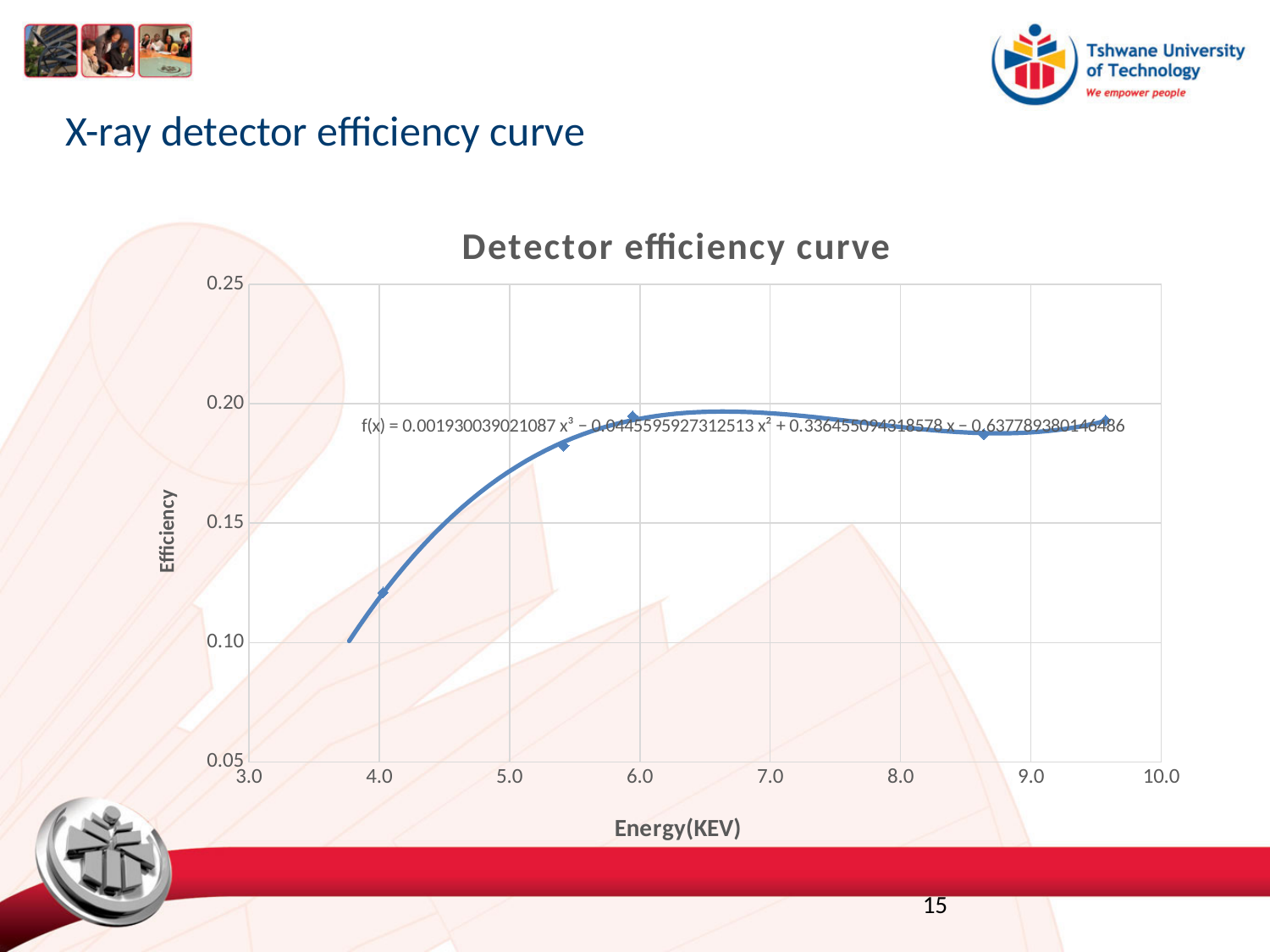
How does efficiency change as energy increases from 4.0 to 6.0 KEV? It rises Is the efficiency of the data point at about 4.0 KEV greater or less than 0.15? less Is the efficiency of the data point near 8.6 KEV greater or less than 0.15? greater What is the label of the x axis? Energy(KEV) How many data points are plotted on the chart? 5 Is the efficiency of the data point near 9.6 KEV greater or less than 0.20? less What is the title of the chart? Detector efficiency curve Which data point has the lowest efficiency? The point at about 4.0 KEV What kind of chart is shown on the slide? Scatter chart with a fitted curve Which has the higher efficiency: the data point at about 4.0 KEV or the one near 6.0 KEV? The one near 6.0 KEV